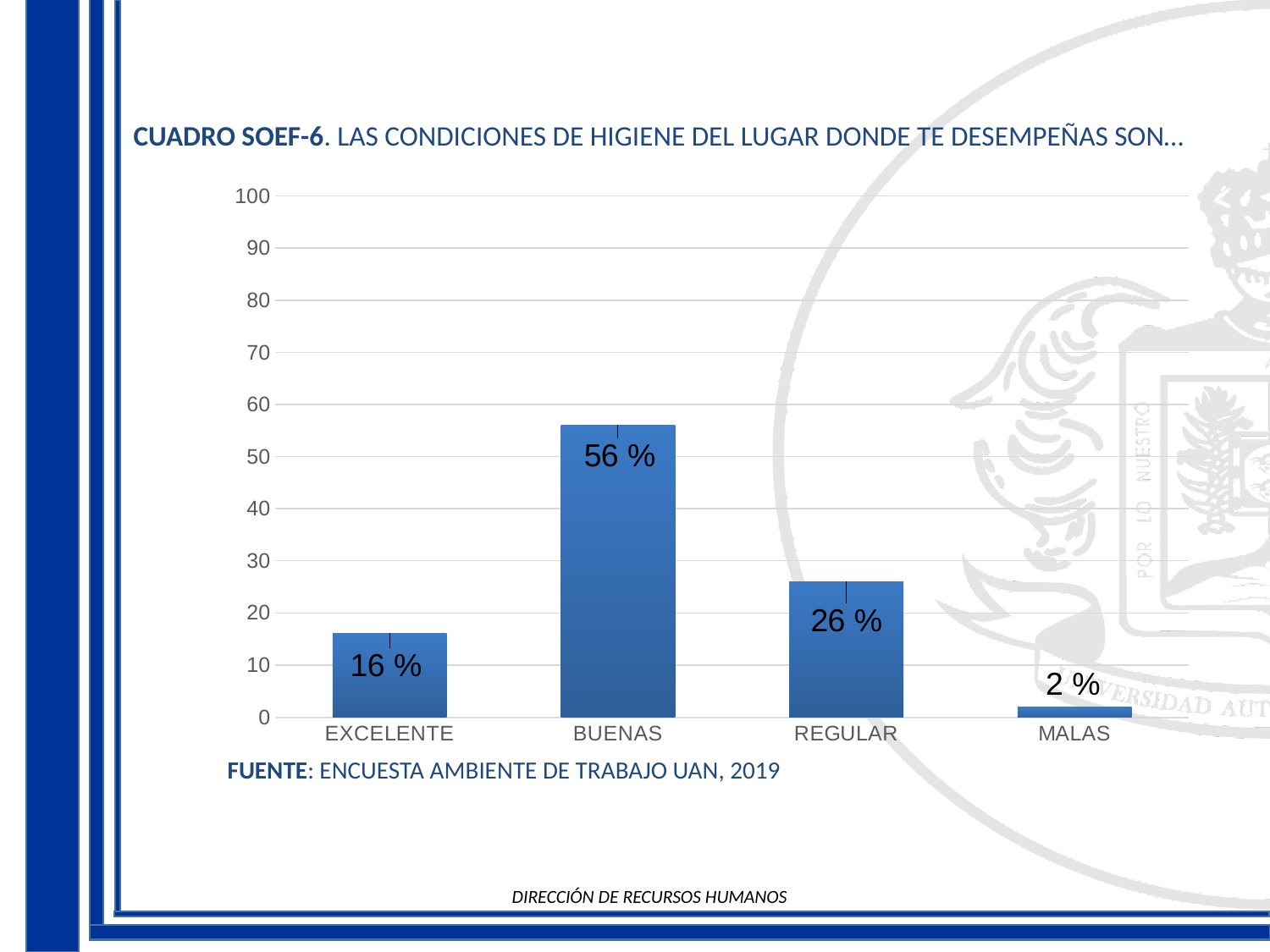
What is the source cited below the chart? ENCUESTA AMBIENTE DE TRABAJO UAN, 2019 How many categories are shown on the x axis? 4 What is the difference between the values for BUENAS and REGULAR? 30 % What is the value for MALAS? 2 % What is the value for EXCELENTE? 16 % Which is larger, the value for EXCELENTE or the value for REGULAR? REGULAR Is the value for BUENAS greater or less than 50? greater Which category has the lowest value? MALAS What is the value for REGULAR? 26 % Which category has the highest value? BUENAS What kind of chart is shown on the slide? bar chart What is the value for BUENAS? 56 %